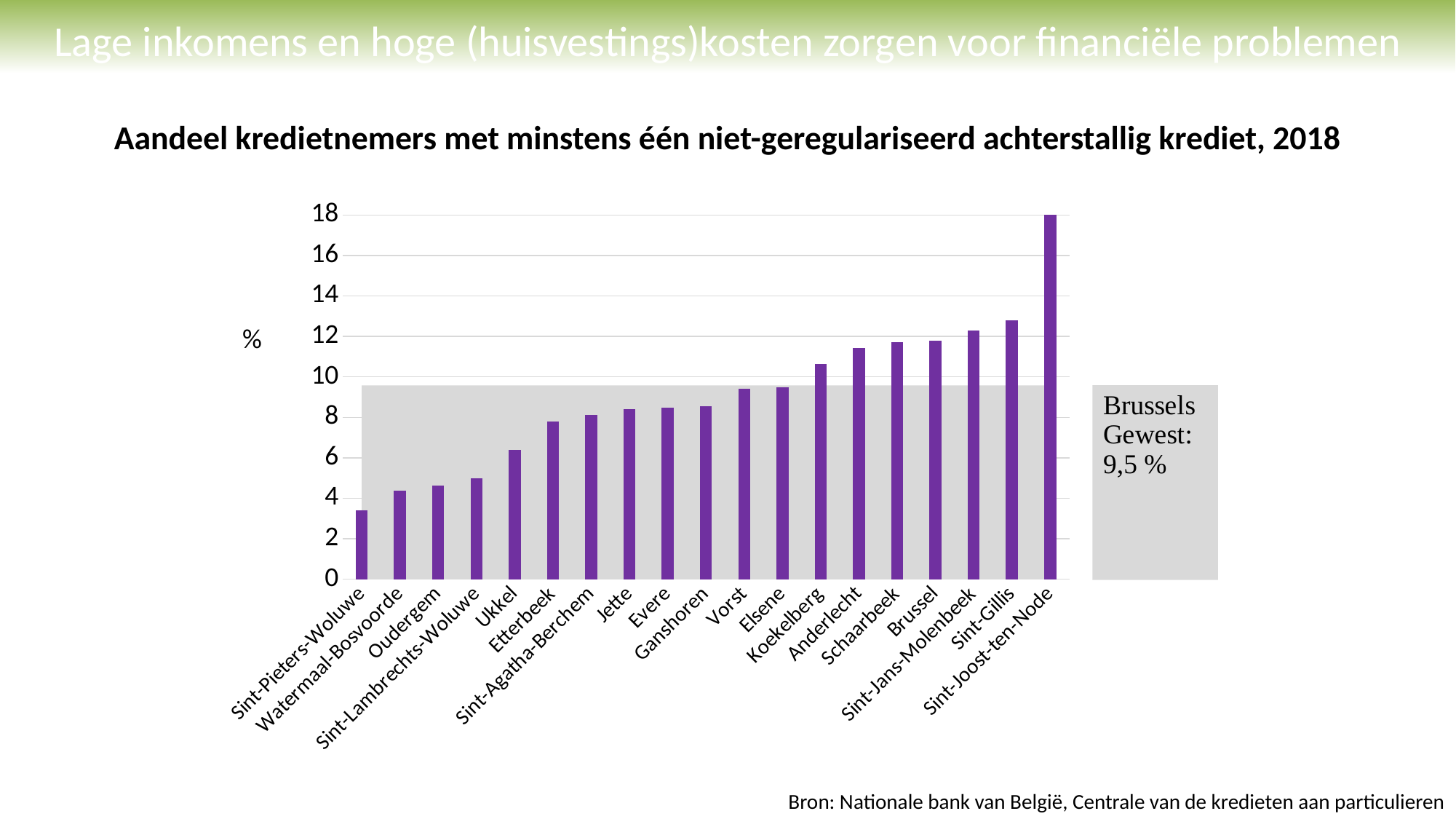
Which municipality has the highest share of borrowers with at least one non-regularised overdue credit? Sint-Joost-ten-Node What value is given for the Brussels Gewest in the annotation next to the chart? 9,5 % Is the value for Ukkel greater or less than 8? less Is the value for Sint-Pieters-Woluwe greater or less than 4? less Which has the larger value, Ukkel or Oudergem? Ukkel Which municipality has the lowest value in the chart? Sint-Pieters-Woluwe How many municipalities are shown on the x axis of the chart? 19 Do the values rise or fall from left to right along the x axis? rise Is the value for Koekelberg greater or less than 10? greater What kind of chart is shown on the slide? bar chart What unit is shown on the y axis of the chart? %